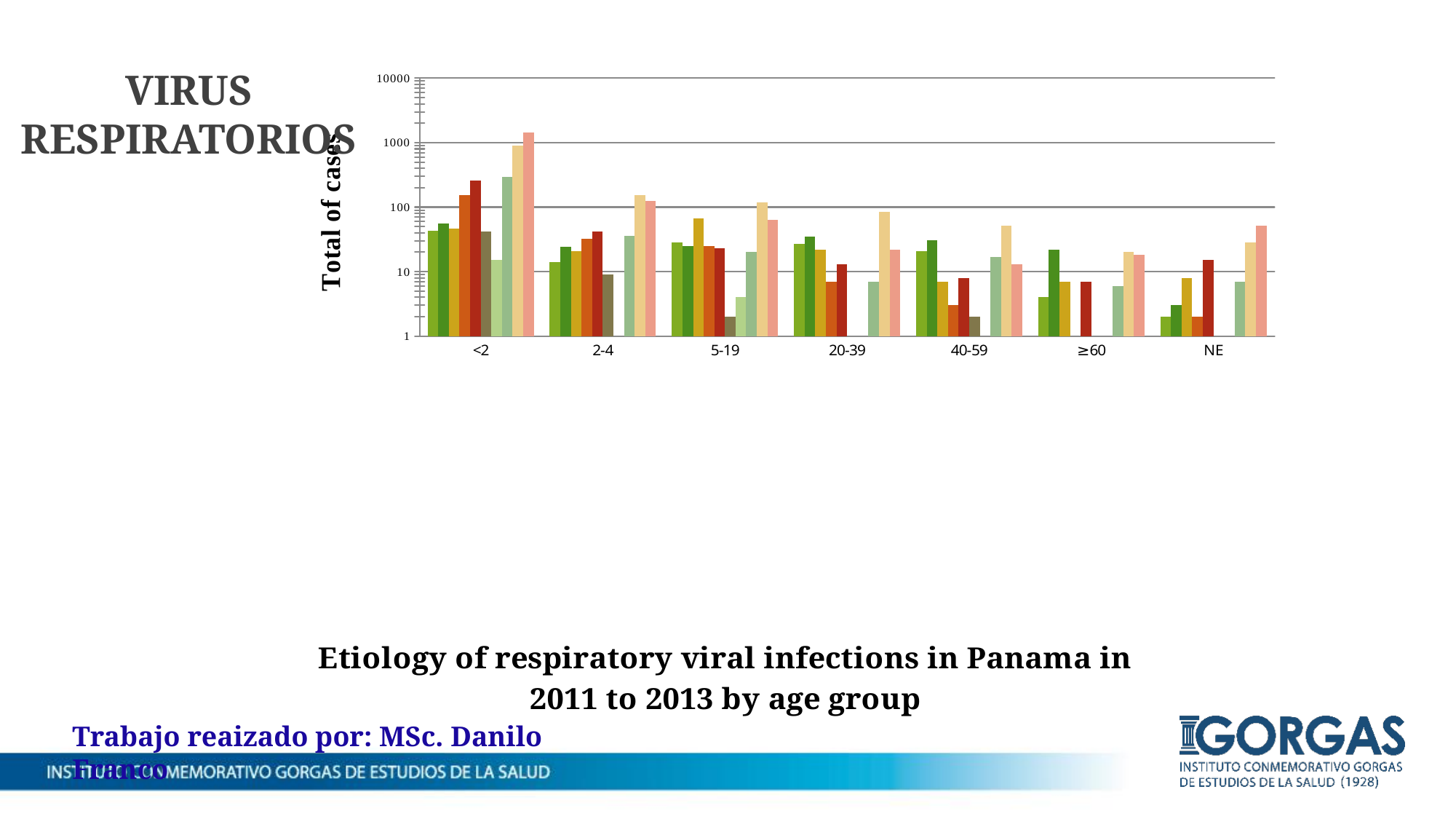
How many age-group categories are shown on the x axis of the chart? 7 What is the highest value shown on the vertical axis of the chart? 10000 Is the tallest bar in the <2 age group greater or less than 1000? greater Which age group contains the tallest bar in the chart? <2 What is the title given for the chart on the slide? Etiology of respiratory viral infections in Panama in 2011 to 2013 by age group Is the tallest bar in the ≥60 age group greater or less than 100? less What kind of chart is shown on the slide? bar chart What is the label of the vertical axis of the chart? Total of cases Which age group has the taller tallest bar, <2 or NE? <2 Is the tallest bar in the 5-19 age group greater or less than 100? greater